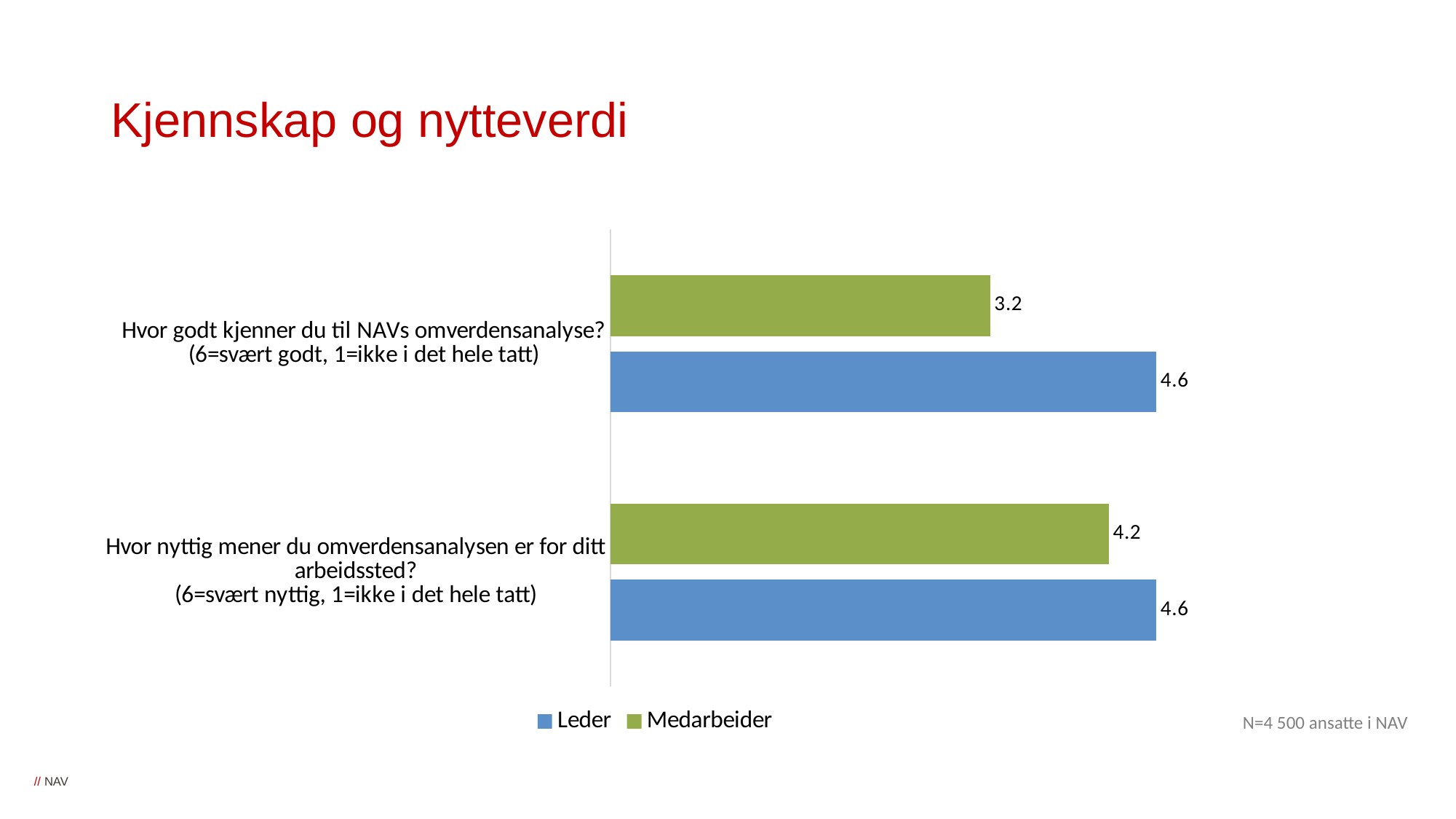
Which colour represents the Medarbeider series? Green What is the difference between the Leder and Medarbeider values for "Hvor godt kjenner du til NAVs omverdensanalyse?"? 1.4 Which question has the lowest Medarbeider value? Hvor godt kjenner du til NAVs omverdensanalyse? What is the difference between the Leder and Medarbeider values for "Hvor nyttig mener du omverdensanalysen er for ditt arbeidssted?"? 0.4 What kind of chart is shown on the slide? Bar chart What is the Medarbeider value for "Hvor nyttig mener du omverdensanalysen er for ditt arbeidssted?"? 4.2 How many series does the legend list? 2 What is the Leder value for "Hvor godt kjenner du til NAVs omverdensanalyse?"? 4.6 What is the Medarbeider value for "Hvor godt kjenner du til NAVs omverdensanalyse?"? 3.2 Which series has the higher value for "Hvor godt kjenner du til NAVs omverdensanalyse?", Leder or Medarbeider? Leder How many question categories are shown on the chart? 2 What is the Leder value for "Hvor nyttig mener du omverdensanalysen er for ditt arbeidssted?"? 4.6